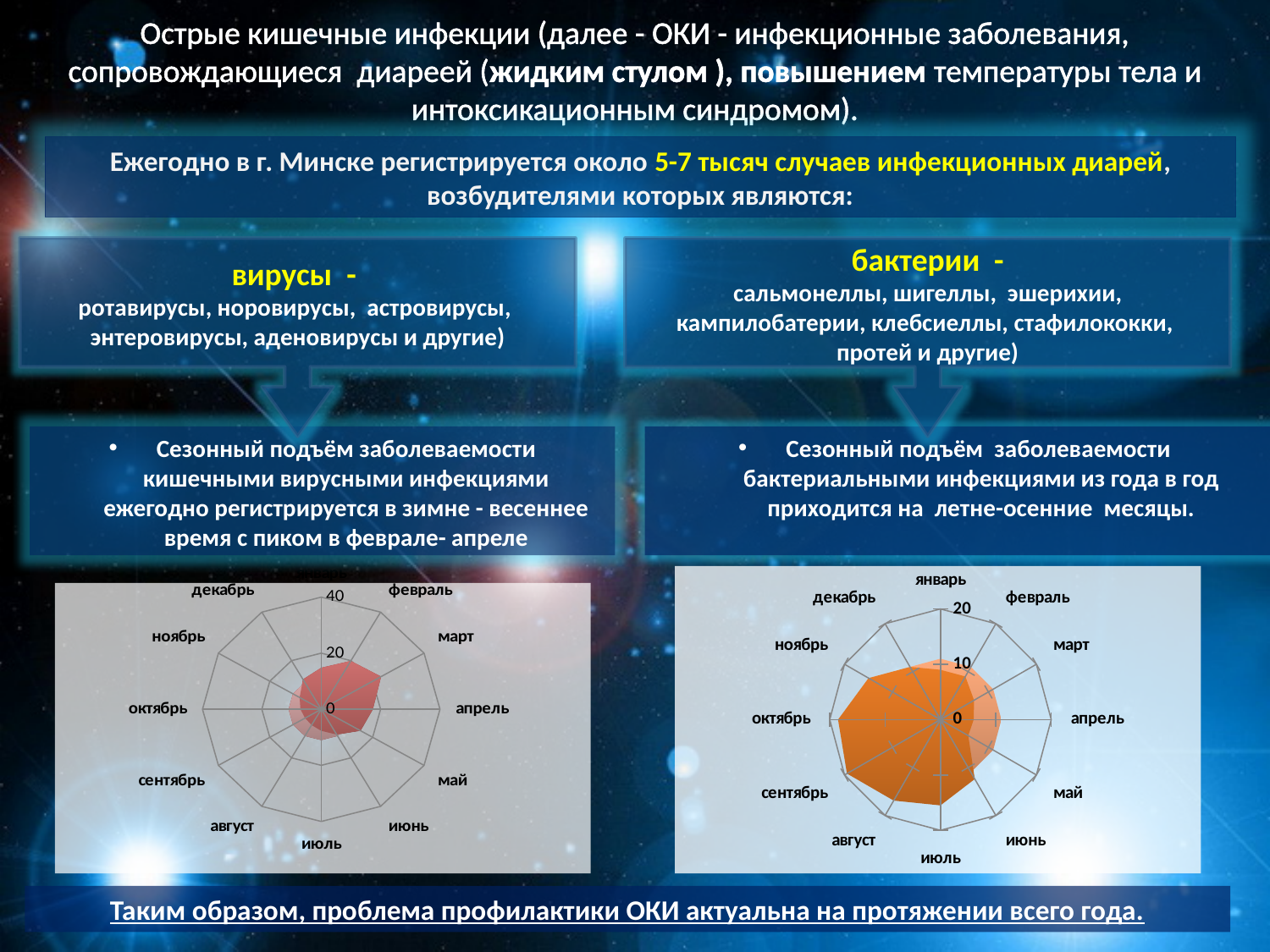
What kind of chart is the right chart (below the text about bacterial infections)? radar chart How many charts are shown on the slide? 2 In the right radar chart, is the value for сентябрь greater or less than 10? greater What kind of chart is the left chart (below the text about viral infections)? radar chart How many categories (months) does the left radar chart have? 12 How many categories (months) does the right radar chart have? 12 In the left radar chart, what is the highest value shown on the axis? 40 In the left radar chart, is the value for сентябрь greater or less than 20? less In the right radar chart, is the value for август greater or less than 10? greater In the right radar chart, what is the highest value shown on the axis? 20